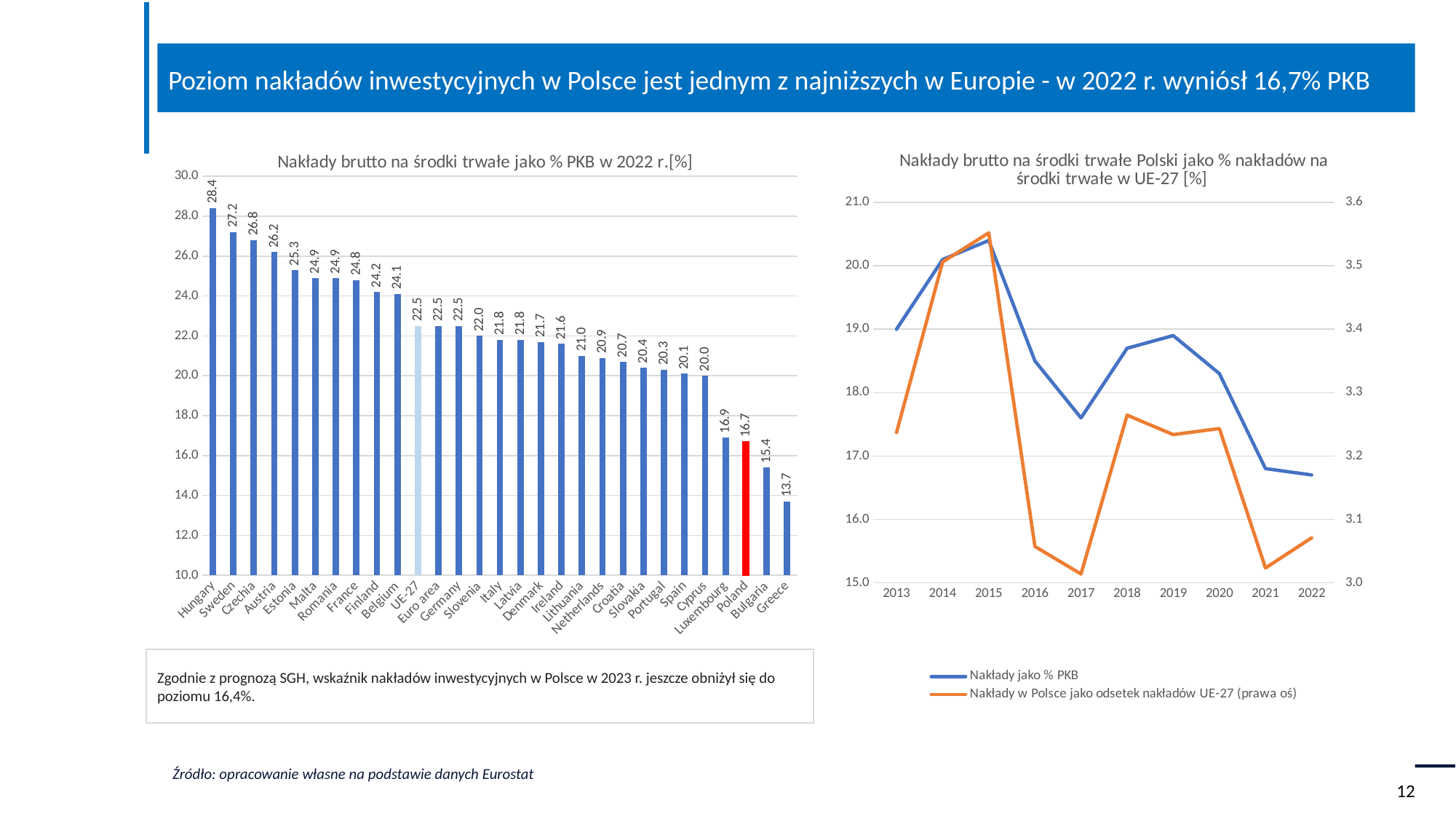
In the left chart 'Nakłady brutto na środki trwałe jako % PKB w 2022 r.', which country has the lowest value? Greece In the left chart 'Nakłady brutto na środki trwałe jako % PKB w 2022 r.', what is the value for Poland? 16.7 In the right chart 'Nakłady brutto na środki trwałe Polski jako % nakładów na środki trwałe w UE-27', is the value of 'Nakłady jako % PKB' in 2022 greater or less than 17.0? less In the left chart 'Nakłady brutto na środki trwałe jako % PKB w 2022 r.', what is the difference between the value for UE-27 and the value for Poland? 5.8 In the right chart 'Nakłady brutto na środki trwałe Polski jako % nakładów na środki trwałe w UE-27', how many series does the legend list? 2 In the left chart 'Nakłady brutto na środki trwałe jako % PKB w 2022 r.', what is the value for Hungary? 28.4 What kind of chart is the left chart 'Nakłady brutto na środki trwałe jako % PKB w 2022 r.'? Bar chart In the left chart 'Nakłady brutto na środki trwałe jako % PKB w 2022 r.', which bar is coloured red? Poland In the left chart 'Nakłady brutto na środki trwałe jako % PKB w 2022 r.', which is larger, the value for Luxembourg or the value for Bulgaria? Luxembourg In the left chart 'Nakłady brutto na środki trwałe jako % PKB w 2022 r.', which category has the highest value? Hungary In the left chart 'Nakłady brutto na środki trwałe jako % PKB w 2022 r.', how many bars are plotted? 29 In the right chart 'Nakłady brutto na środki trwałe Polski jako % nakładów na środki trwałe w UE-27', how many years are shown on the x axis? 10